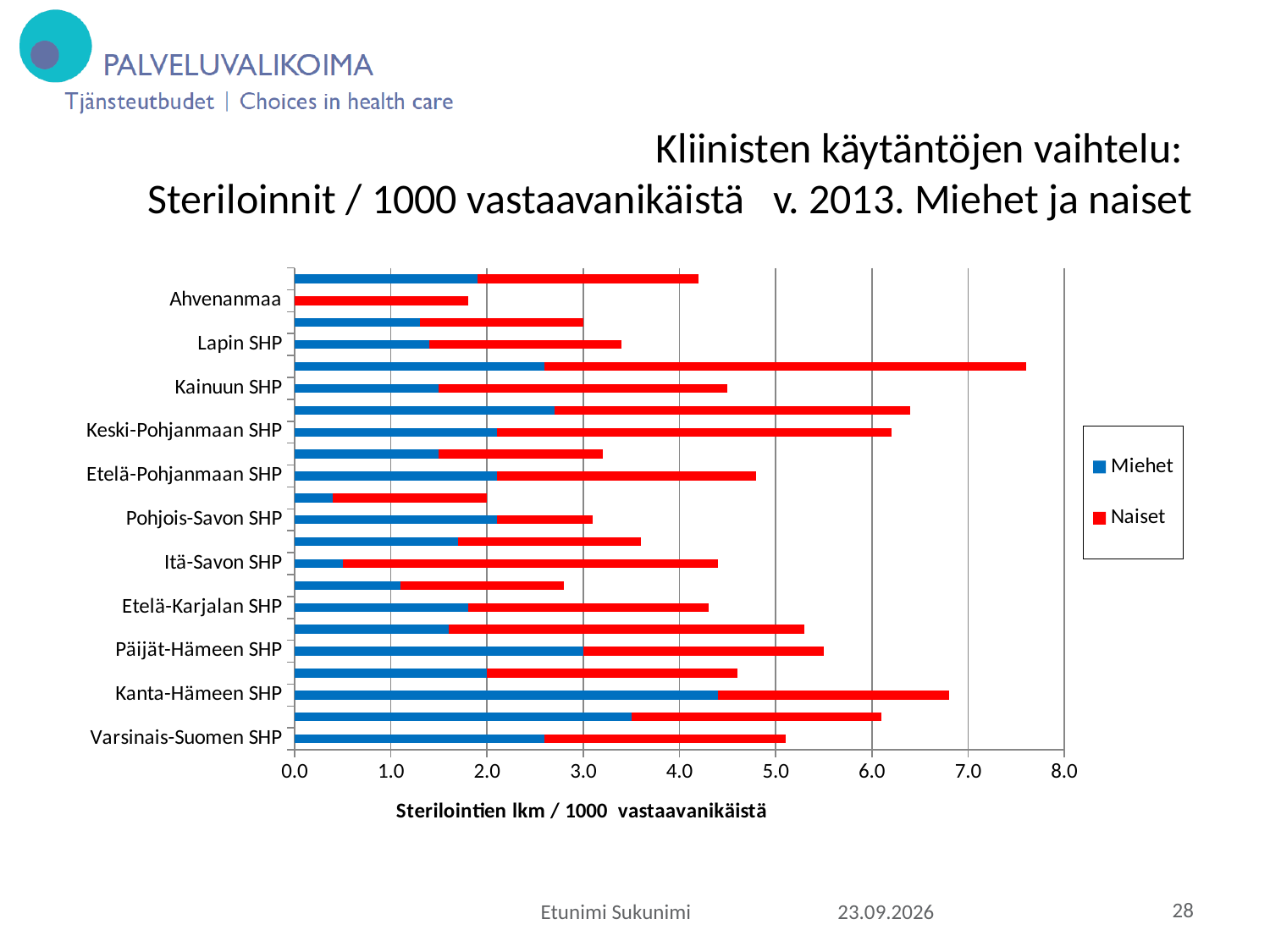
Is the total value for Kanta-Hämeen SHP greater or less than 6.0? greater What colour represents the Naiset series? red Is the total value for Ahvenanmaa greater or less than 2.0? less Is the total value for Pohjois-Savon SHP greater or less than 4.0? less Which two series are listed in the legend? Miehet and Naiset What kind of chart is shown on the slide? bar chart How many series does the legend list? 2 Which has the larger total value, Kanta-Hämeen SHP or Lapin SHP? Kanta-Hämeen SHP